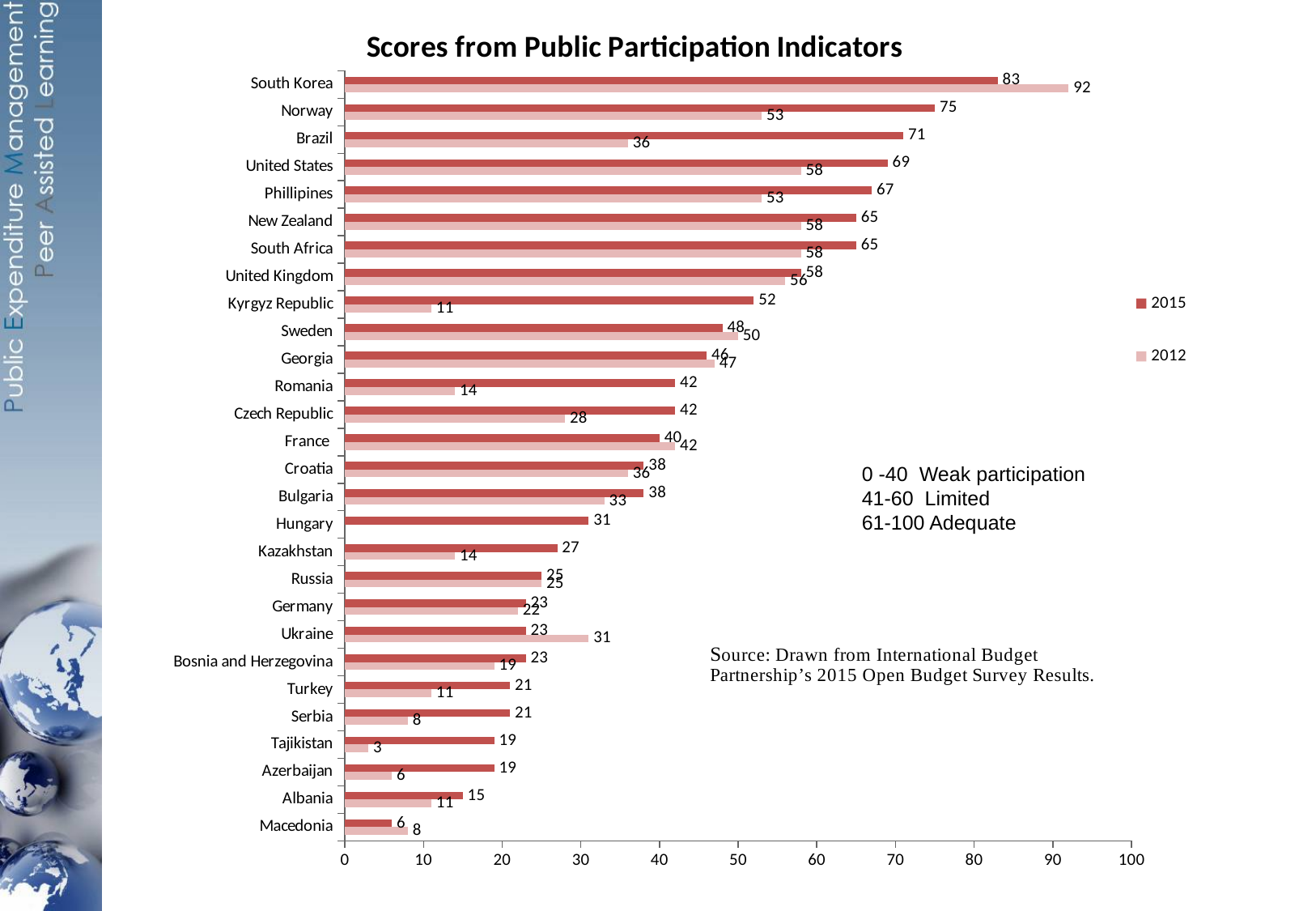
What is the 2012 score for the Kyrgyz Republic? 11 What type of chart is shown on the slide? bar chart What is the title of the chart? Scores from Public Participation Indicators Which country has the highest 2012 score? South Korea How many countries are listed on the chart? 28 Which is larger for Sweden, the 2015 score or the 2012 score? 2012 What is the 2015 score for Brazil? 71 Which country has the lowest 2015 score? Macedonia How many series does the legend list? 2 Which series is shown in the darker red colour? 2015 What is the difference between Norway's 2015 and 2012 scores? 22 What is the 2012 score for Ukraine? 31